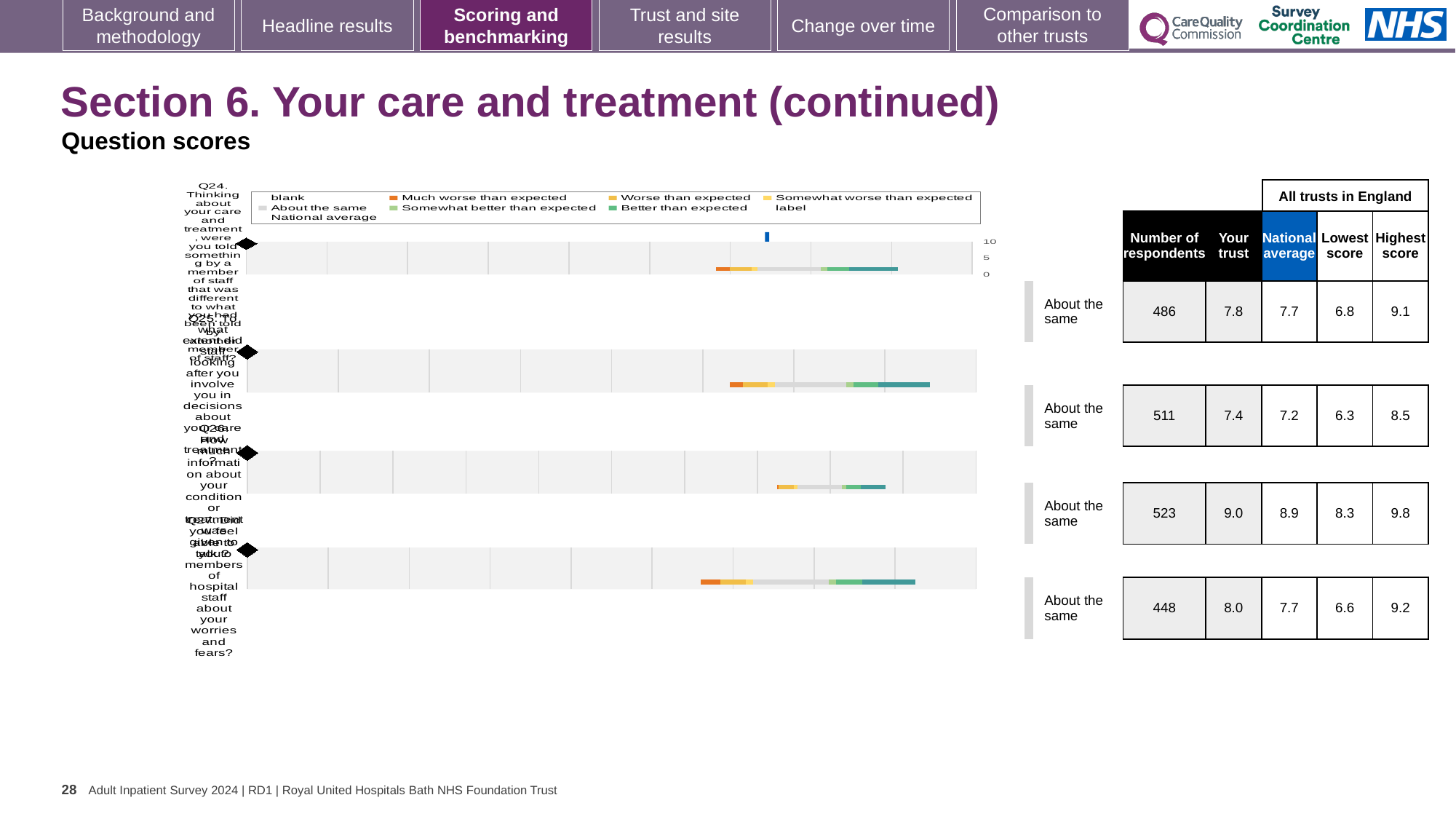
What benchmark category is shown for the first chart (Q24)? About the same How many question charts are shown on the slide? 4 Which of the four questions has the lowest number of respondents? Q27 (448) For the second chart (Q25), which is larger: the 'Your trust' score or the national average? Your trust (7.4) For the third chart (Q26), what is the highest score among all trusts in England? 9.8 What kind of chart is used for each question on the slide? Bar chart For the first chart (Q24), what is the 'Your trust' score shown in the table? 7.8 For the second chart (Q25), how many respondents are listed? 511 For the first chart (Q24), what is the national average score? 7.7 For the fourth chart (Q27), what is the lowest score among all trusts in England? 6.6 Which of the four questions has the highest 'Your trust' score? Q26 (9.0) For the fourth chart (Q27), what is the difference between the 'Your trust' score and the national average? 0.3